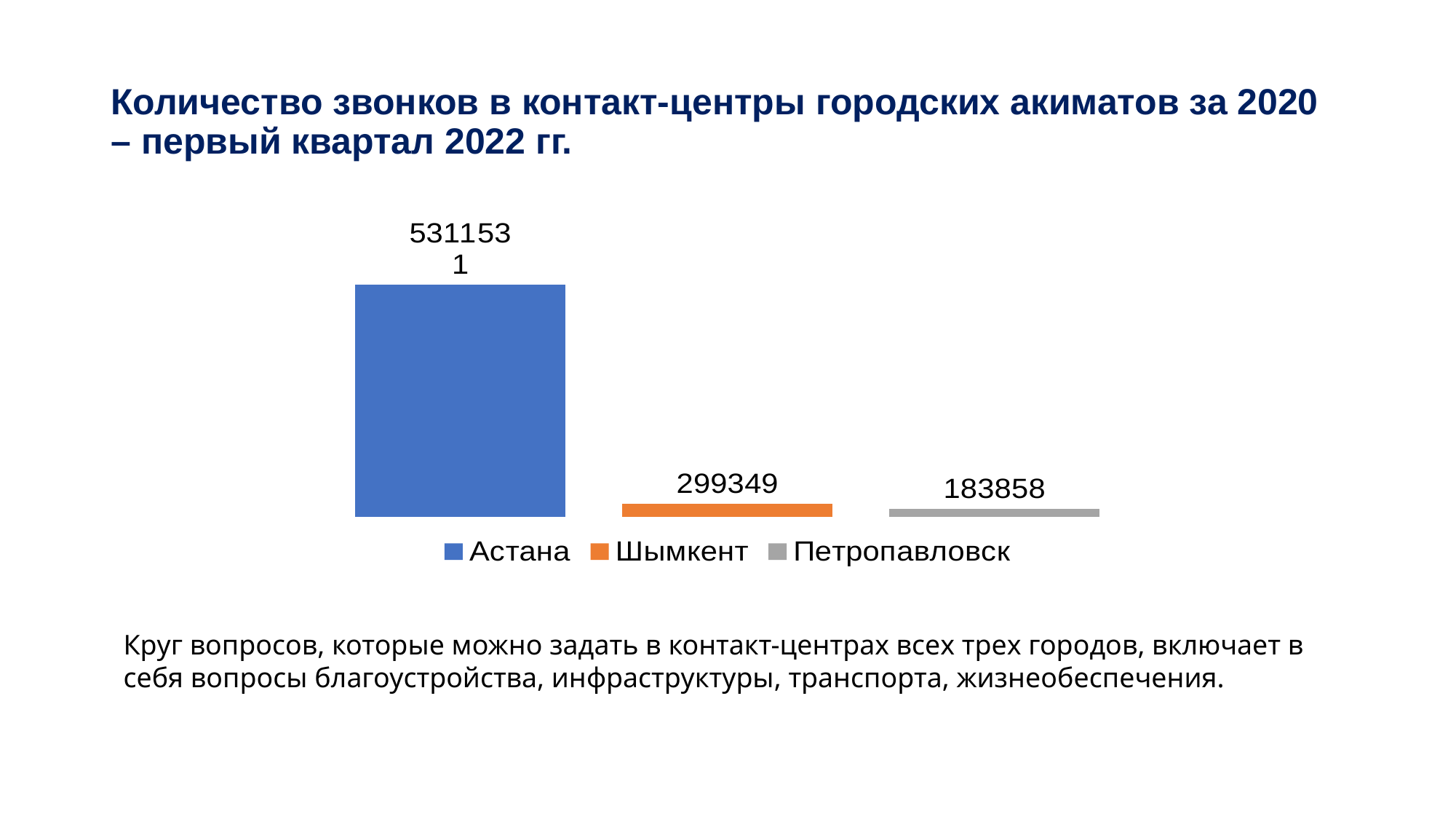
How many cities are shown in the chart? 3 What kind of chart is shown on the slide? Bar chart What is the value shown for Шымкент? 299349 What is the difference between the values for Шымкент and Петропавловск? 115491 Do the values rise or fall from left to right across the bars? Fall Which city has the highest number of calls? Астана How many entries does the legend list? 3 What colour is the bar for Шымкент? Orange What is the value shown for Астана? 5311531 What is the value shown for Петропавловск? 183858 Which is larger, the value for Шымкент or the value for Петропавловск? Шымкент Which city has the lowest number of calls? Петропавловск